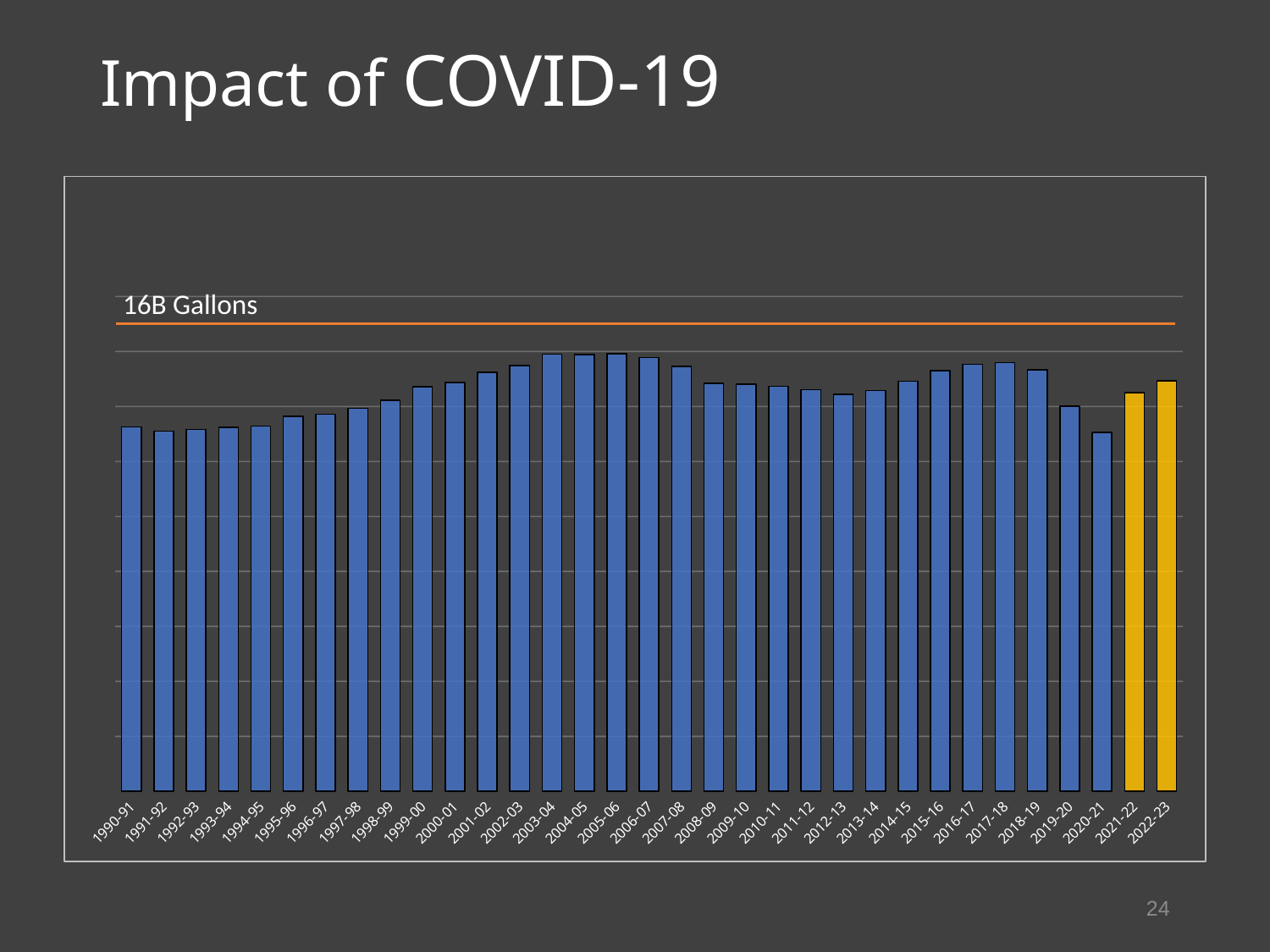
Which is larger, the value for 2018-19 or the value for 2020-21? 2018-19 What is the title of the slide containing the chart? Impact of COVID-19 What label is shown on the horizontal orange reference line in the chart? 16B Gallons What kind of chart is shown on the slide? bar chart Is the value for 2005-06 greater or less than 16B gallons? less Which is larger, the value for 2019-20 or the value for 2020-21? 2019-20 Which is larger, the value for 2005-06 or the value for 1990-91? 2005-06 Do the values rise or fall from 2017-18 to 2020-21? fall Do the values rise or fall from 1994-95 to 2005-06? rise How many year categories are shown along the x axis of the chart? 33 Is the value for 2020-21 greater or less than 16B gallons? less